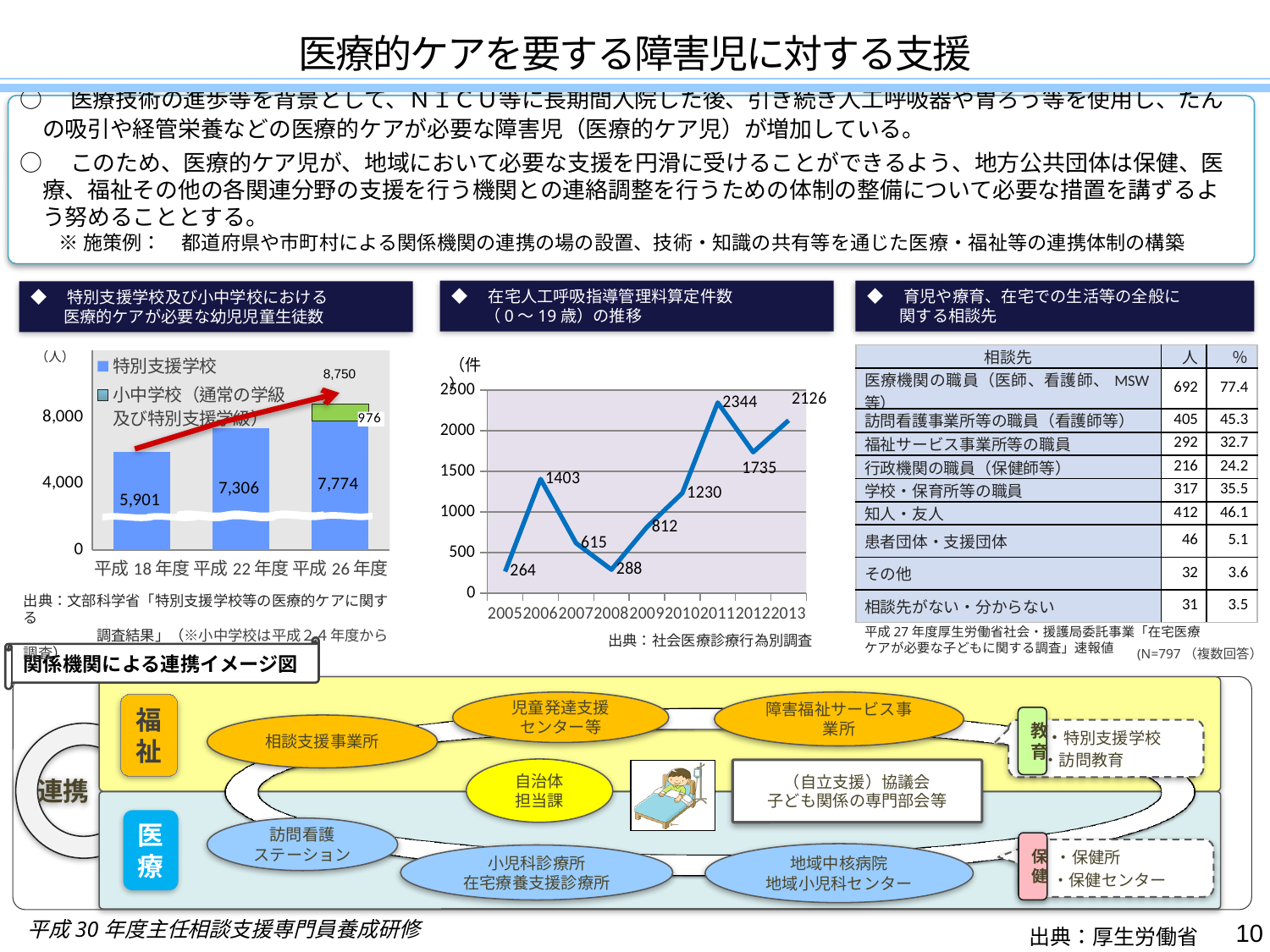
In the left bar chart, what is the difference between the 特別支援学校 values for 平成22年度 and 平成18年度? 1,405 In the left bar chart, what is the value for 小中学校 in 平成26年度? 976 In the left bar chart (特別支援学校及び小中学校における医療的ケアが必要な幼児児童生徒数), what is the value for 特別支援学校 in 平成18年度? 5,901 In the left bar chart, do the 特別支援学校 values rise or fall from 平成18年度 to 平成26年度? rise In the middle chart (在宅人工呼吸指導管理料算定件数の推移), what is the value for 2011? 2344 In the left bar chart, what is the total of the stacked bar for 平成26年度? 8,750 In the middle chart, which year has the lowest value? 2005 In the middle chart, what is the difference between the values for 2013 and 2012? 391 In the middle chart, which year has the highest value? 2011 What kind of chart is the middle chart (在宅人工呼吸指導管理料算定件数の推移)? line chart In the left bar chart, how many series does the legend list? 2 In the left bar chart, what is the value for 特別支援学校 in 平成26年度? 7,774